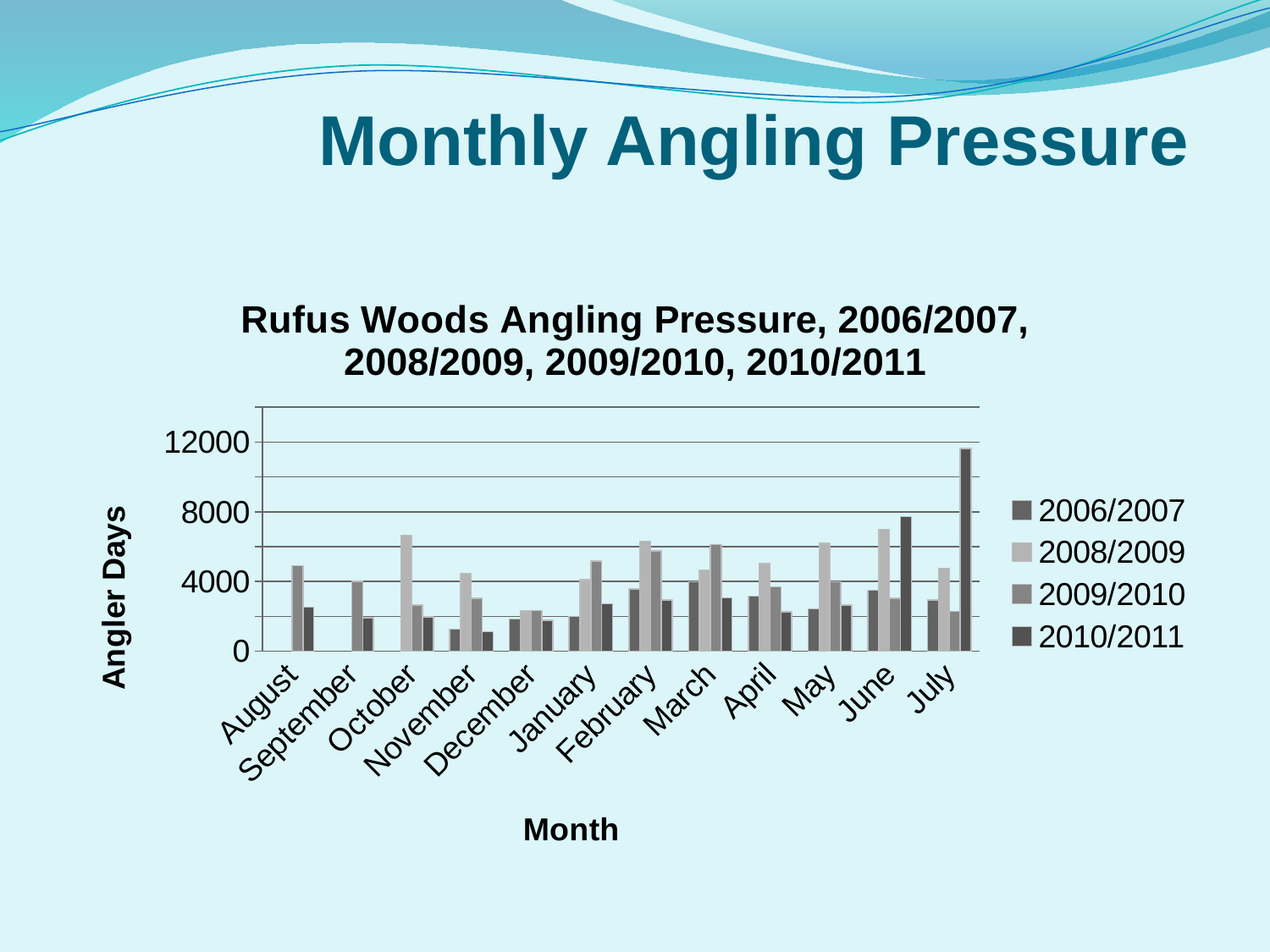
Is the value for 2009/2010 in March greater or less than 4000? greater In July, which series has the highest value? 2010/2011 What is the title of the x axis? Month What is the title of the y axis? Angler Days What kind of chart is shown on the slide? bar chart How many series does the legend list? 4 Is the value for 2008/2009 in October greater or less than 4000? greater How many months are shown on the x axis? 12 Which month has the tallest bar in the chart? July Is the value for 2010/2011 in July greater or less than 8000? greater